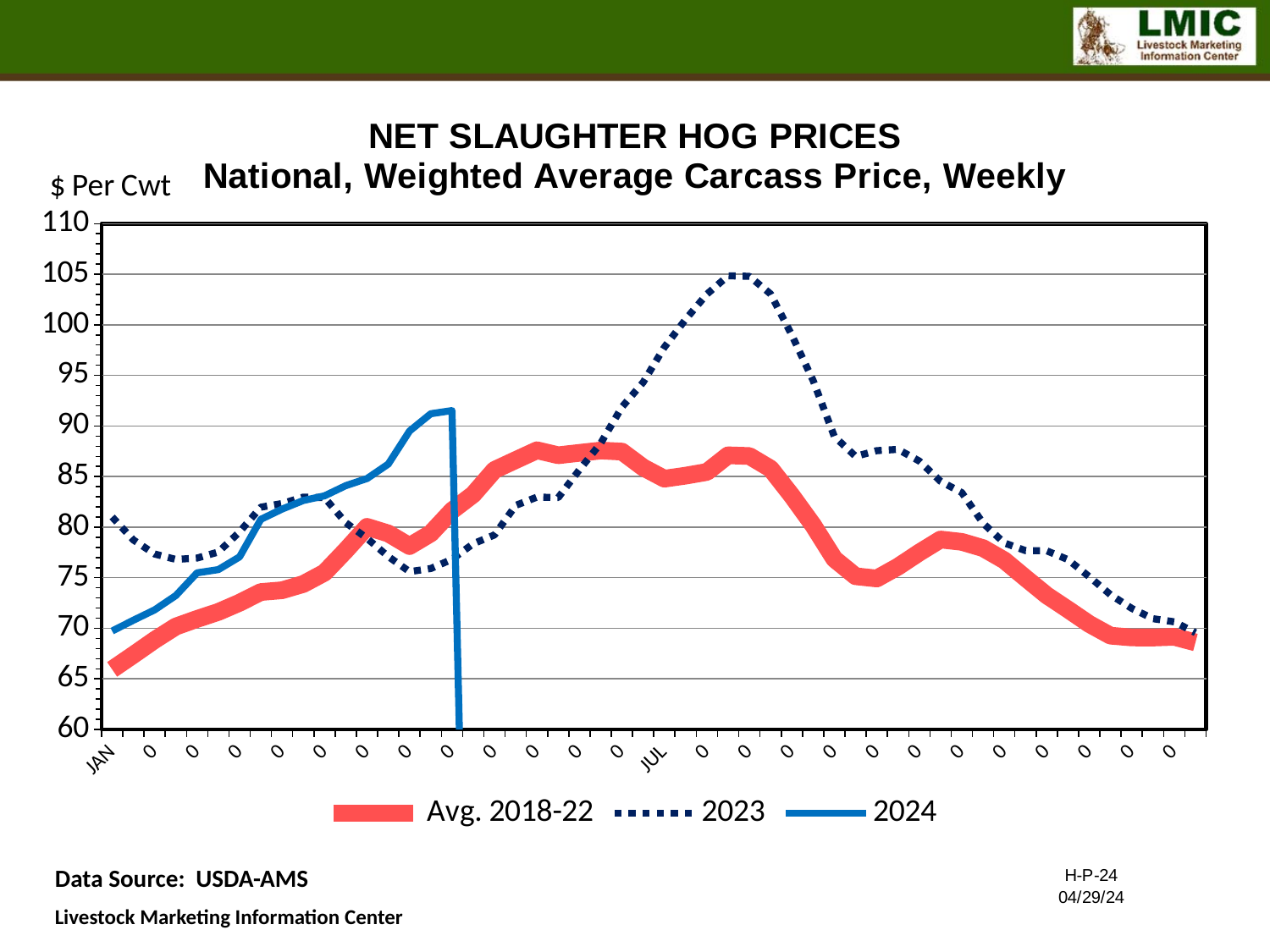
Is the value of the Avg. 2018-22 series at JAN greater or less than 70? less Does the 2024 series rise or fall from JAN to its last plotted point before dropping off? rise Which series reaches the highest value on the chart? 2023 Is the highest value of the 2024 series greater or less than 85? greater What is the data source cited below the chart? USDA-AMS Is the peak value of the 2023 series greater or less than 100? greater At JUL, which series is higher: 2023 or Avg. 2018-22? 2023 What type of chart is shown on the slide? line chart Does the 2023 series rise or fall from its peak to the end of the year? fall How many series does the legend list? 3 What is the title of the chart? NET SLAUGHTER HOG PRICES, National, Weighted Average Carcass Price, Weekly